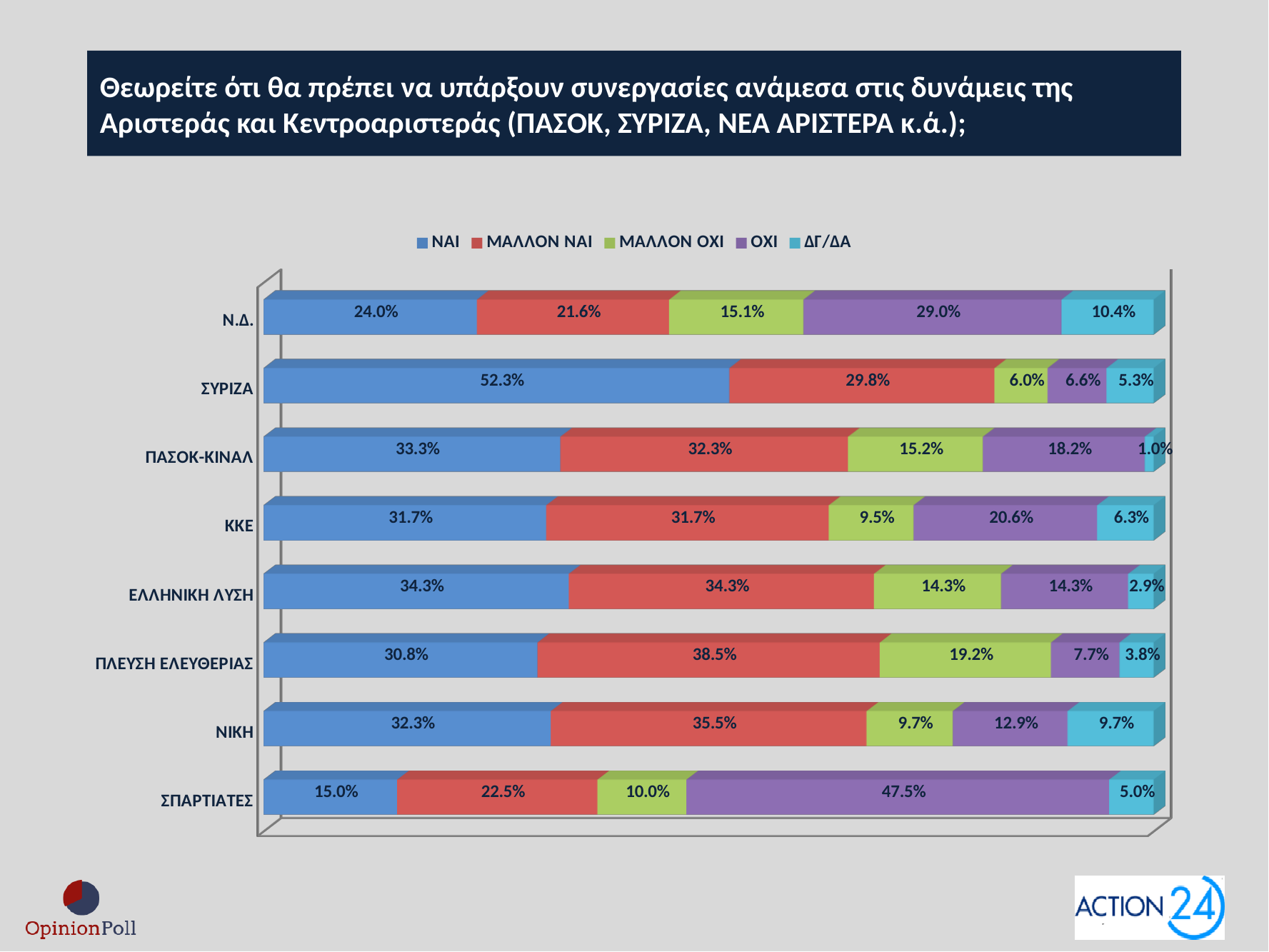
What is the ΟΧΙ value for ΣΠΑΡΤΙΑΤΕΣ? 47.5% How many categories (parties) are shown on the chart? 8 What is the ΔΓ/ΔΑ value for ΠΑΣΟΚ-ΚΙΝΑΛ? 1.0% What is the ΜΑΛΛΟΝ ΟΧΙ value for ΠΛΕΥΣΗ ΕΛΕΥΘΕΡΙΑΣ? 19.2% Which category has the highest ΝΑΙ value? ΣΥΡΙΖΑ What kind of chart is shown on the slide? Stacked bar chart Which is larger, the ΜΑΛΛΟΝ ΝΑΙ value for ΝΙΚΗ or the ΜΑΛΛΟΝ ΝΑΙ value for ΚΚΕ? ΝΙΚΗ How many series does the legend list? 5 What is the combined ΝΑΙ and ΜΑΛΛΟΝ ΝΑΙ value for ΣΥΡΙΖΑ? 82.1% Which category has the lowest ΝΑΙ value? ΣΠΑΡΤΙΑΤΕΣ What is the difference between the ΟΧΙ value for ΣΠΑΡΤΙΑΤΕΣ and the ΟΧΙ value for Ν.Δ.? 18.5% What is the ΝΑΙ value for ΣΥΡΙΖΑ? 52.3%